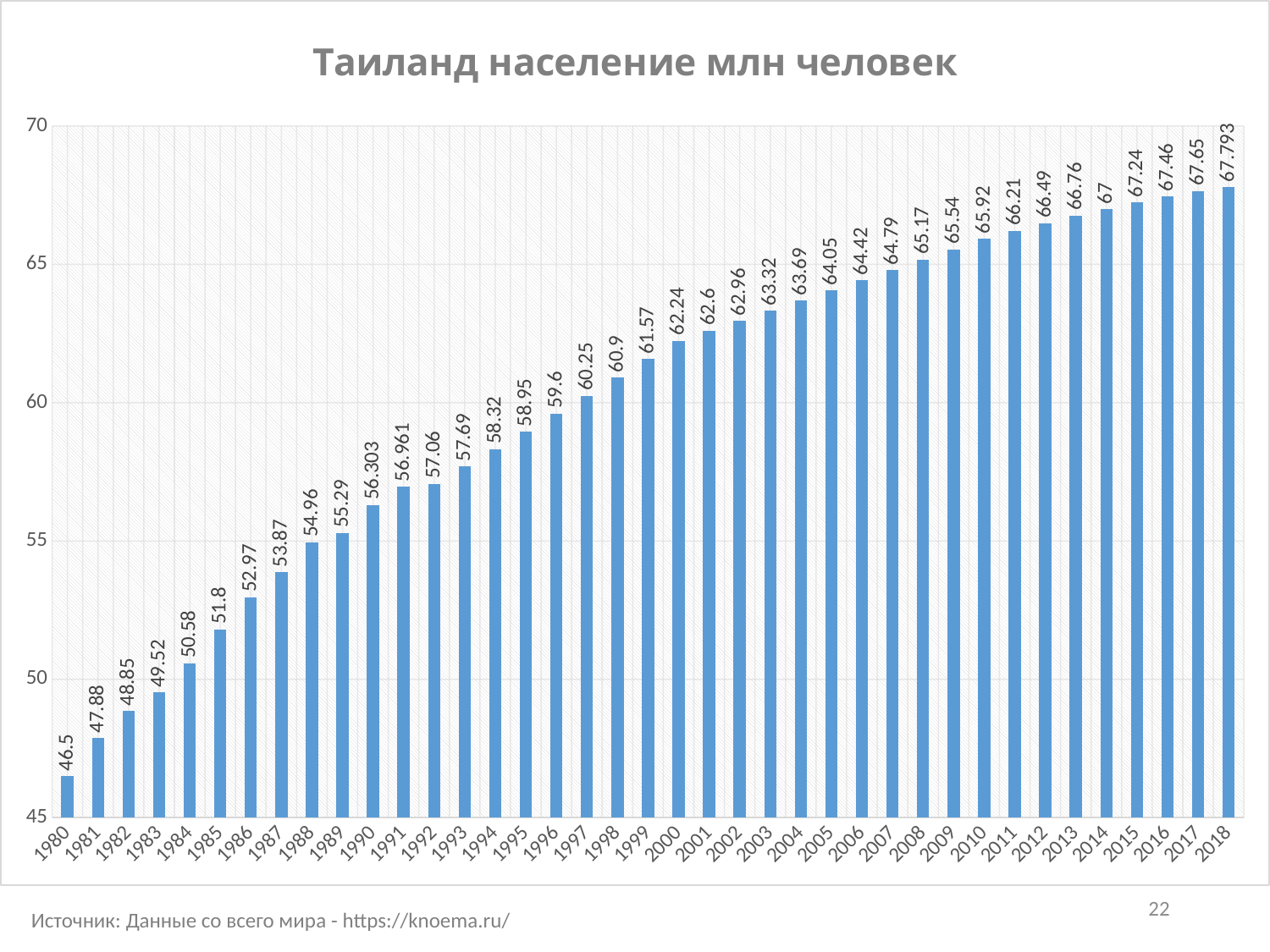
Which year has the highest population value? 2018 What kind of chart is this? bar chart Which year has the lowest population value? 1980 What is the population value shown for 2018? 67.793 How many years (bars) are shown on the chart? 39 Which year has the larger population value, 1985 or 1995? 1995 What is the population value shown for 2000? 62.24 What is the population value shown for 1991? 56.961 Do the values rise or fall from 1980 to 2018? rise What is the difference between the population values for 2010 and 2000? 3.68 What is the population value shown for 1980? 46.5 Is the value for 1995 greater or less than 60? less